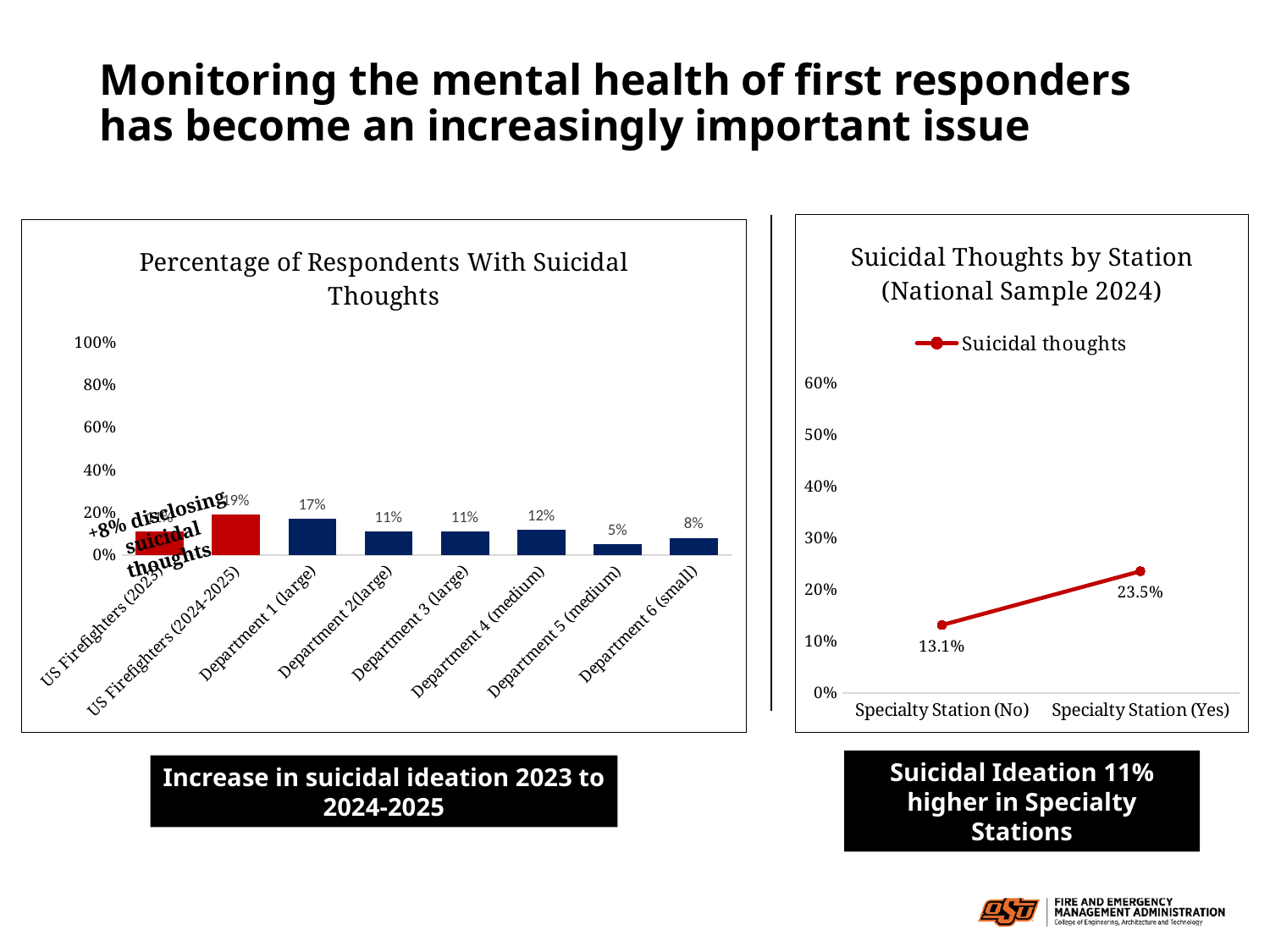
In the chart titled "Percentage of Respondents With Suicidal Thoughts", is the value for Department 3 (large) greater or less than 20%? less In the chart titled "Suicidal Thoughts by Station (National Sample 2024)", does the value rise or fall from Specialty Station (No) to Specialty Station (Yes)? Rise In the chart titled "Percentage of Respondents With Suicidal Thoughts", what is the value for Department 5 (medium)? 5% In the chart titled "Suicidal Thoughts by Station (National Sample 2024)", what is the difference between Specialty Station (Yes) and Specialty Station (No)? 10.4% In the chart titled "Percentage of Respondents With Suicidal Thoughts", how many categories are shown on the x axis? 8 In the chart titled "Percentage of Respondents With Suicidal Thoughts", which is larger: Department 4 (medium) or Department 2 (large)? Department 4 (medium) In the chart titled "Percentage of Respondents With Suicidal Thoughts", what is the difference between Department 1 (large) and Department 6 (small)? 9% In the chart titled "Suicidal Thoughts by Station (National Sample 2024)", what is the value for Specialty Station (Yes)? 23.5% How many series does the legend list in the chart titled "Suicidal Thoughts by Station (National Sample 2024)"? 1 In the chart titled "Percentage of Respondents With Suicidal Thoughts", what is the value for Department 1 (large)? 17% What kind of chart is the one titled "Percentage of Respondents With Suicidal Thoughts"? Bar chart In the chart titled "Percentage of Respondents With Suicidal Thoughts", which category has the lowest value? Department 5 (medium)